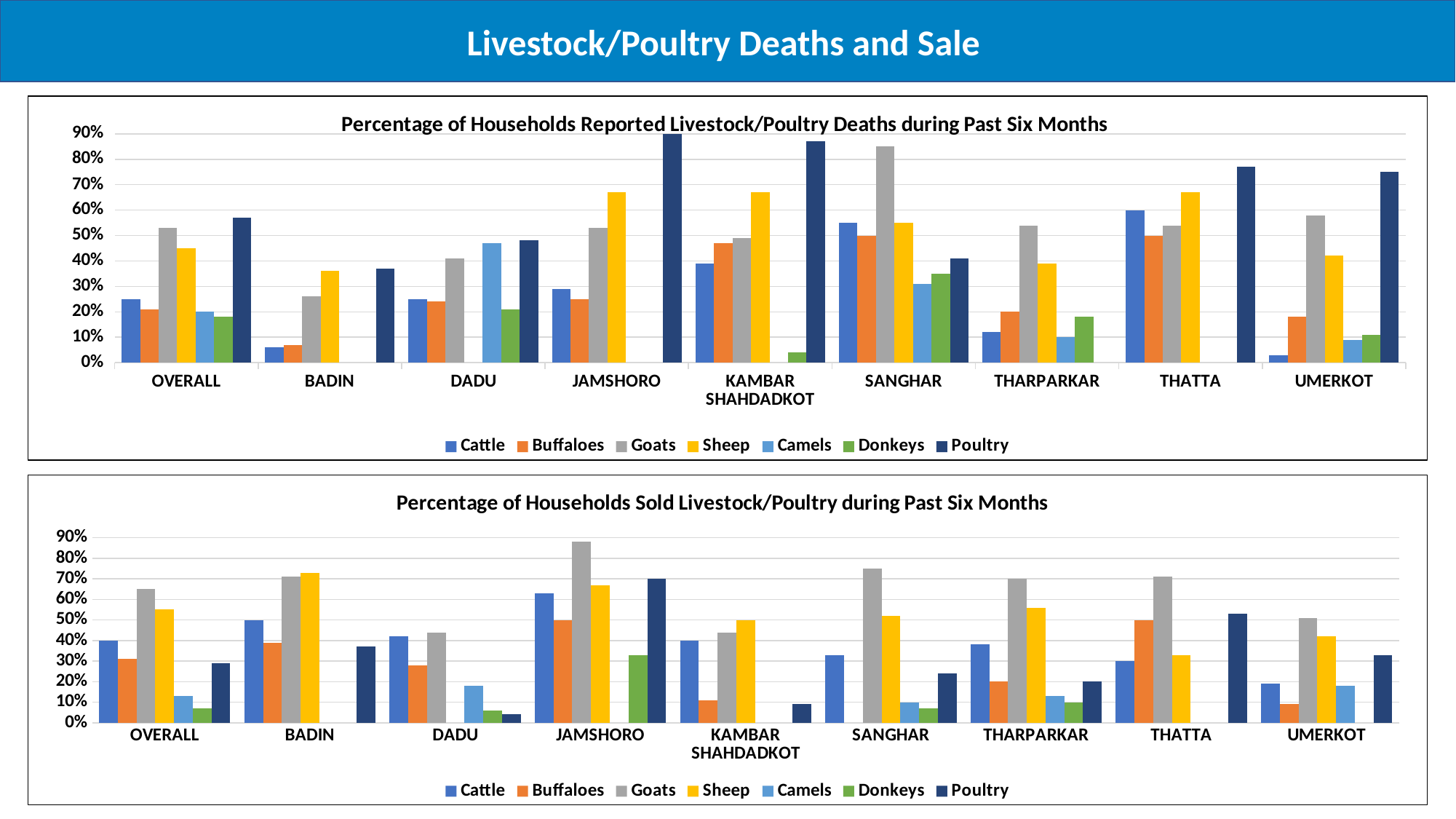
In the top chart (Percentage of Households Reported Livestock/Poultry Deaths during Past Six Months), is the value for Poultry in JAMSHORO greater or less than 80%? greater In the top chart (Percentage of Households Reported Livestock/Poultry Deaths during Past Six Months), is the value for Goats in SANGHAR greater or less than 80%? greater In the bottom chart (Percentage of Households Sold Livestock/Poultry during Past Six Months), is the value for Goats in JAMSHORO greater or less than 80%? greater What is the title of the bottom chart on the slide? Percentage of Households Sold Livestock/Poultry during Past Six Months How many series does the legend of the bottom chart (Percentage of Households Sold Livestock/Poultry during Past Six Months) list? 7 How many categories are shown on the x axis of the top chart (Percentage of Households Reported Livestock/Poultry Deaths during Past Six Months)? 9 In the bottom chart (Percentage of Households Sold Livestock/Poultry during Past Six Months), which district has the highest value for Goats? JAMSHORO In the top chart (Percentage of Households Reported Livestock/Poultry Deaths during Past Six Months), for OVERALL, which is larger: Goats or Sheep? Goats What kind of chart is the top chart (Percentage of Households Reported Livestock/Poultry Deaths during Past Six Months)? Bar chart In the bottom chart (Percentage of Households Sold Livestock/Poultry during Past Six Months), for OVERALL, which is larger: Cattle or Buffaloes? Cattle